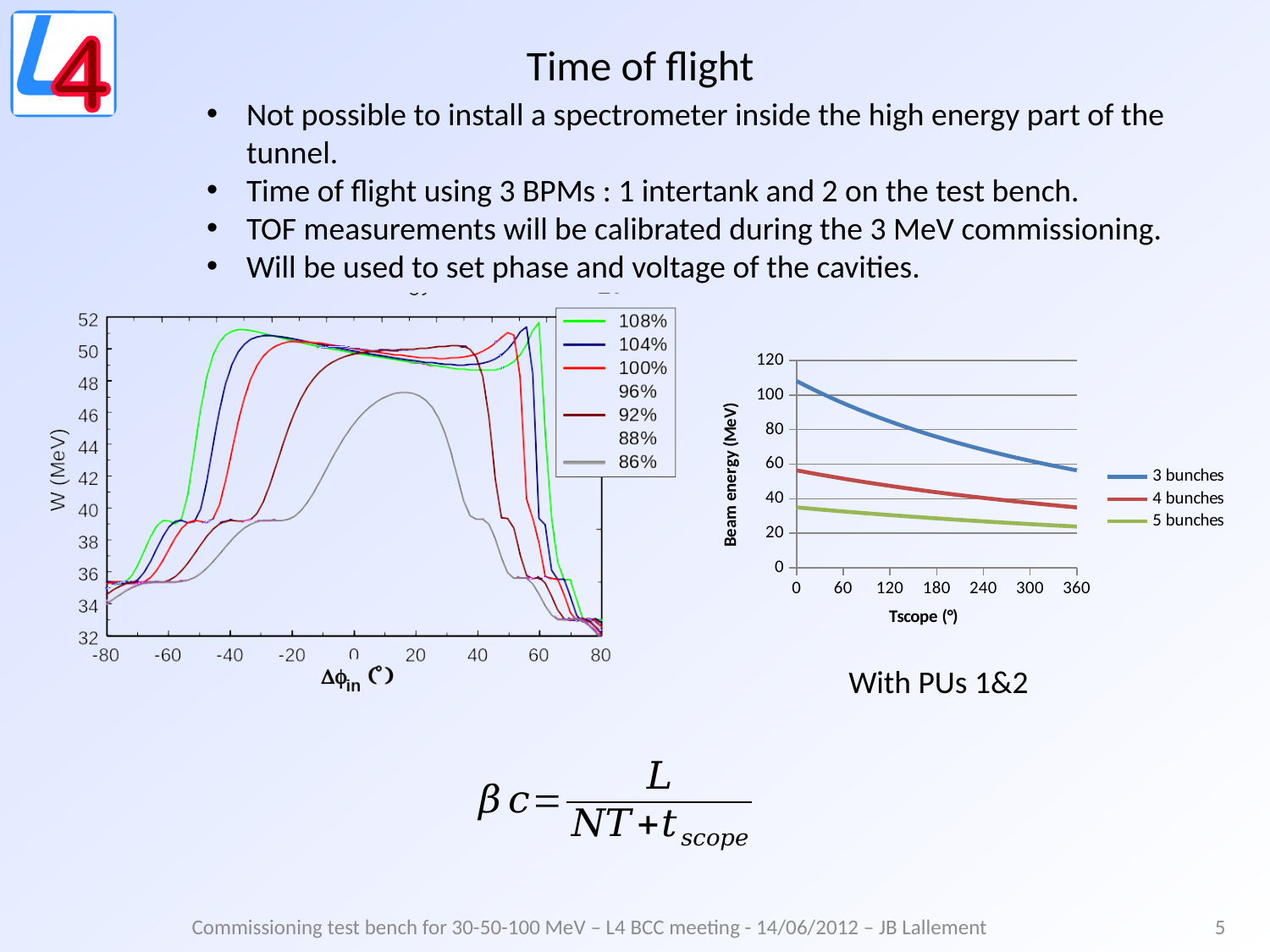
What is the x-axis title of the right-hand chart (Beam energy vs Tscope)? Tscope (°) What kind of chart is the left-hand chart (W vs Δφin)? line chart In the right-hand chart (Beam energy vs Tscope), is the beam energy for 3 bunches at Tscope 0 greater or less than 100? greater In the left-hand chart (W vs Δφin), which curve has the higher W at Δφin = 0: 108% or 86%? 108% How many series does the legend of the left-hand chart (W vs Δφin) list? 7 How many series does the legend of the right-hand chart (Beam energy vs Tscope) list? 3 In the left-hand chart (W vs Δφin), is the peak value of the 86% curve greater or less than 48? less In the right-hand chart (Beam energy vs Tscope), which series has the lowest beam energy across the whole Tscope range? 5 bunches In the right-hand chart (Beam energy vs Tscope), does the beam energy for 3 bunches rise or fall as Tscope increases? fall In the right-hand chart (Beam energy vs Tscope), which series has the higher beam energy at Tscope 180: 3 bunches or 5 bunches? 3 bunches What kind of chart is the right-hand chart (Beam energy vs Tscope)? line chart In the right-hand chart (Beam energy vs Tscope), is the beam energy for 5 bunches at Tscope 0 greater or less than 40? less